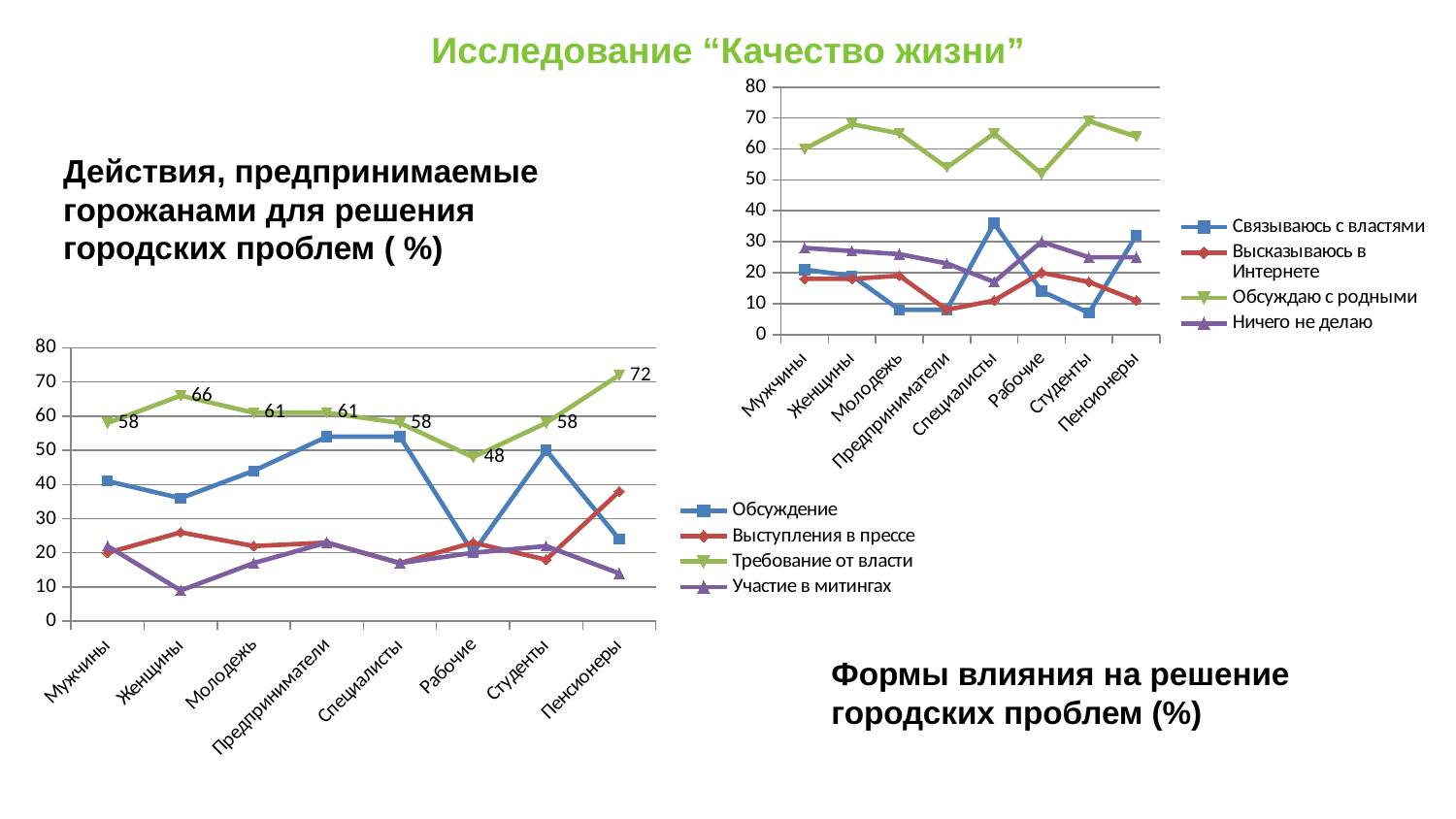
In the right chart (Формы влияния на решение городских проблем), is the value of Обсуждаю с родными for Студенты greater or less than 60? greater In the left chart (Действия, предпринимаемые горожанами для решения городских проблем), which is larger for Требование от власти: Женщины or Молодежь? Женщины In the left chart (Действия, предпринимаемые горожанами для решения городских проблем), what is the difference between the Требование от власти values for Пенсионеры and Рабочие? 24 How many series does the legend of the left chart (Действия, предпринимаемые горожанами для решения городских проблем) list? 4 In the left chart (Действия, предпринимаемые горожанами для решения городских проблем), what is the value of Требование от власти for Женщины? 66 What kind of chart is the right chart (Формы влияния на решение городских проблем)? Line chart In the left chart (Действия, предпринимаемые горожанами для решения городских проблем), what is the value of Требование от власти for Пенсионеры? 72 In the right chart (Формы влияния на решение городских проблем), which series has the highest values across all categories? Обсуждаю с родными How many categories are shown on the x axis of the left chart (Действия, предпринимаемые горожанами для решения городских проблем)? 8 In the left chart (Действия, предпринимаемые горожанами для решения городских проблем), which category has the highest value for Требование от власти? Пенсионеры In the left chart (Действия, предпринимаемые горожанами для решения городских проблем), which category has the lowest value for Требование от власти? Рабочие In the right chart (Формы влияния на решение городских проблем), is the value of Связываюсь с властями for Молодежь greater or less than 20? less